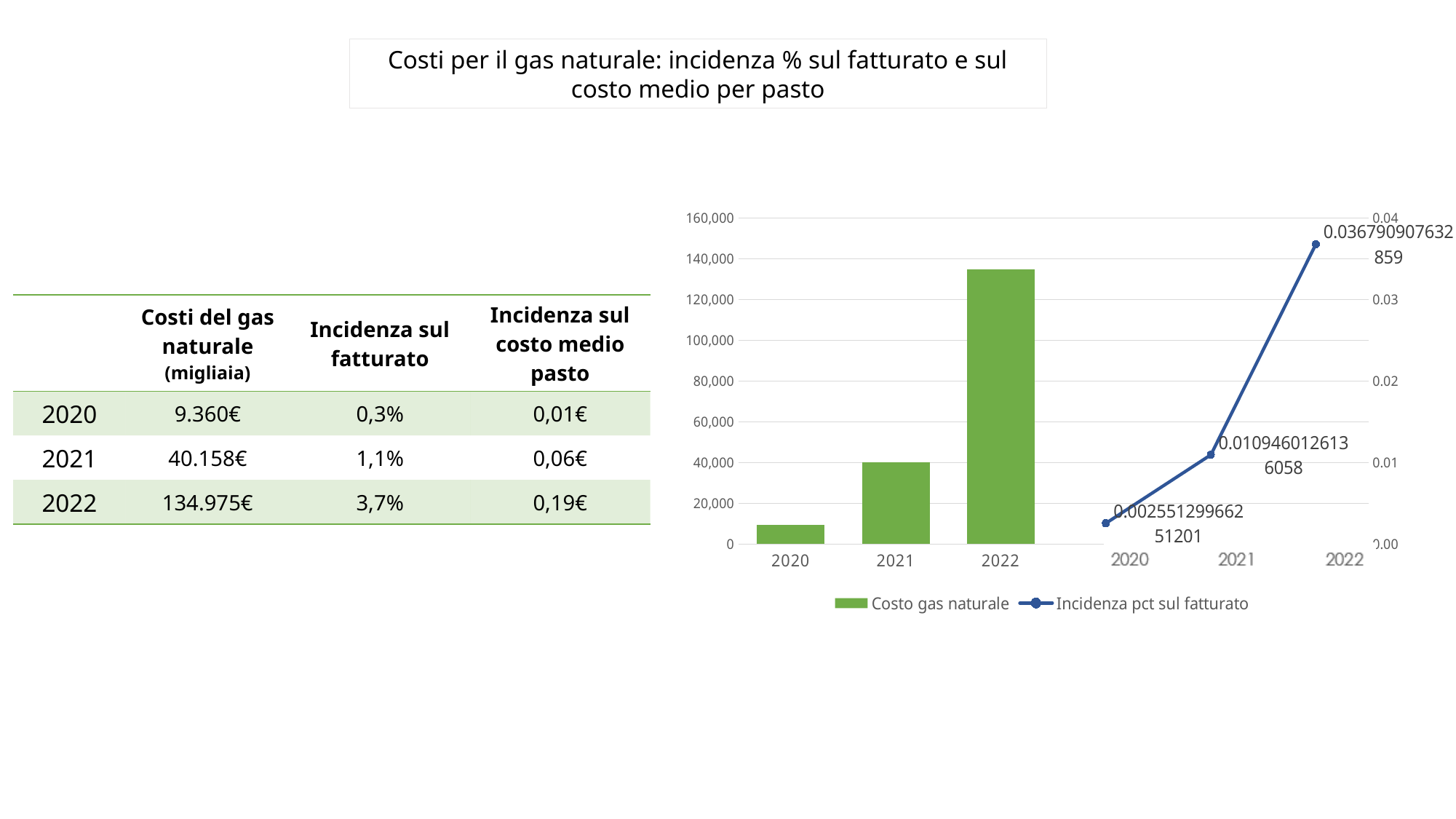
Is the Costo gas naturale bar for 2021 greater or less than 60,000? less Is the Costo gas naturale bar for 2022 greater or less than 120,000? greater Is the Incidenza pct sul fatturato value for 2022 greater or less than 0.03? greater Does the Incidenza pct sul fatturato line rise or fall from 2020 to 2022? It rises How many years are plotted on the chart's x axis? 3 How many series does the chart legend list? 2 Which year has the lowest bar for Costo gas naturale? 2020 What are the two entries in the chart legend? Costo gas naturale and Incidenza pct sul fatturato What kind of chart is shown on the slide? A combined bar and line chart Which year has the highest bar for Costo gas naturale? 2022 Which year has the larger Costo gas naturale bar, 2020 or 2021? 2021